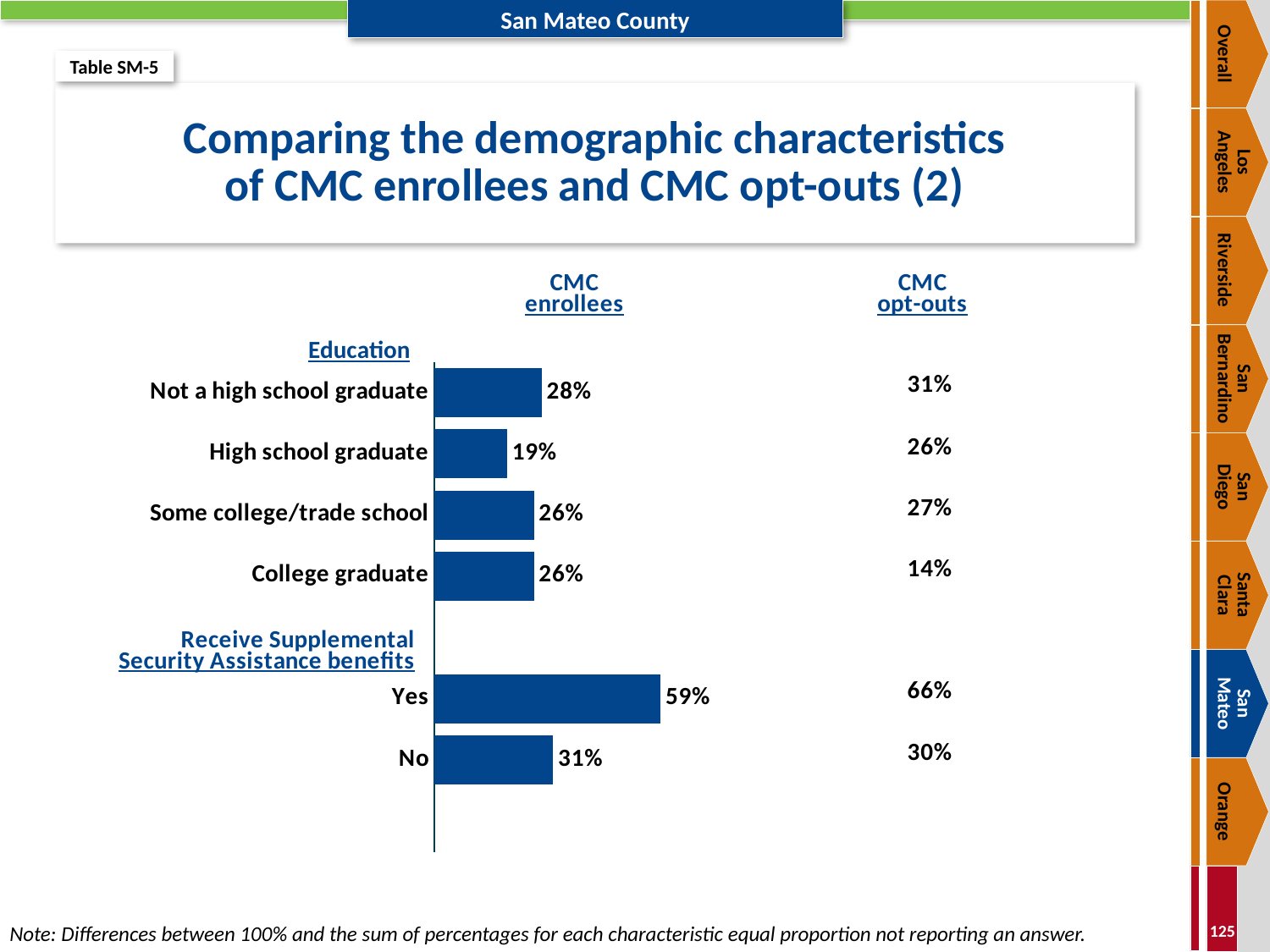
What is the title of the slide containing the chart? Comparing the demographic characteristics of CMC enrollees and CMC opt-outs (2) What percentage of CMC opt-outs are college graduates? 14% What percentage of CMC enrollees receive Supplemental Security Assistance benefits (Yes)? 59% What percentage of CMC enrollees are not a high school graduate? 28% What percentage of CMC enrollees are high school graduates? 19% How many bars are plotted in the CMC enrollees chart? 6 Which bar in the CMC enrollees chart is the longest? Yes (Receive Supplemental Security Assistance benefits) What is the difference between the CMC enrollees percentages for Yes and No under Receive Supplemental Security Assistance benefits? 28% What kind of chart is used to show the CMC enrollees values? Bar chart Among the Education categories, which has the lowest percentage of CMC enrollees? High school graduate What is the difference between the CMC opt-outs and CMC enrollees percentages for Not a high school graduate? 3% Which is larger for CMC enrollees: Not a high school graduate or High school graduate? Not a high school graduate